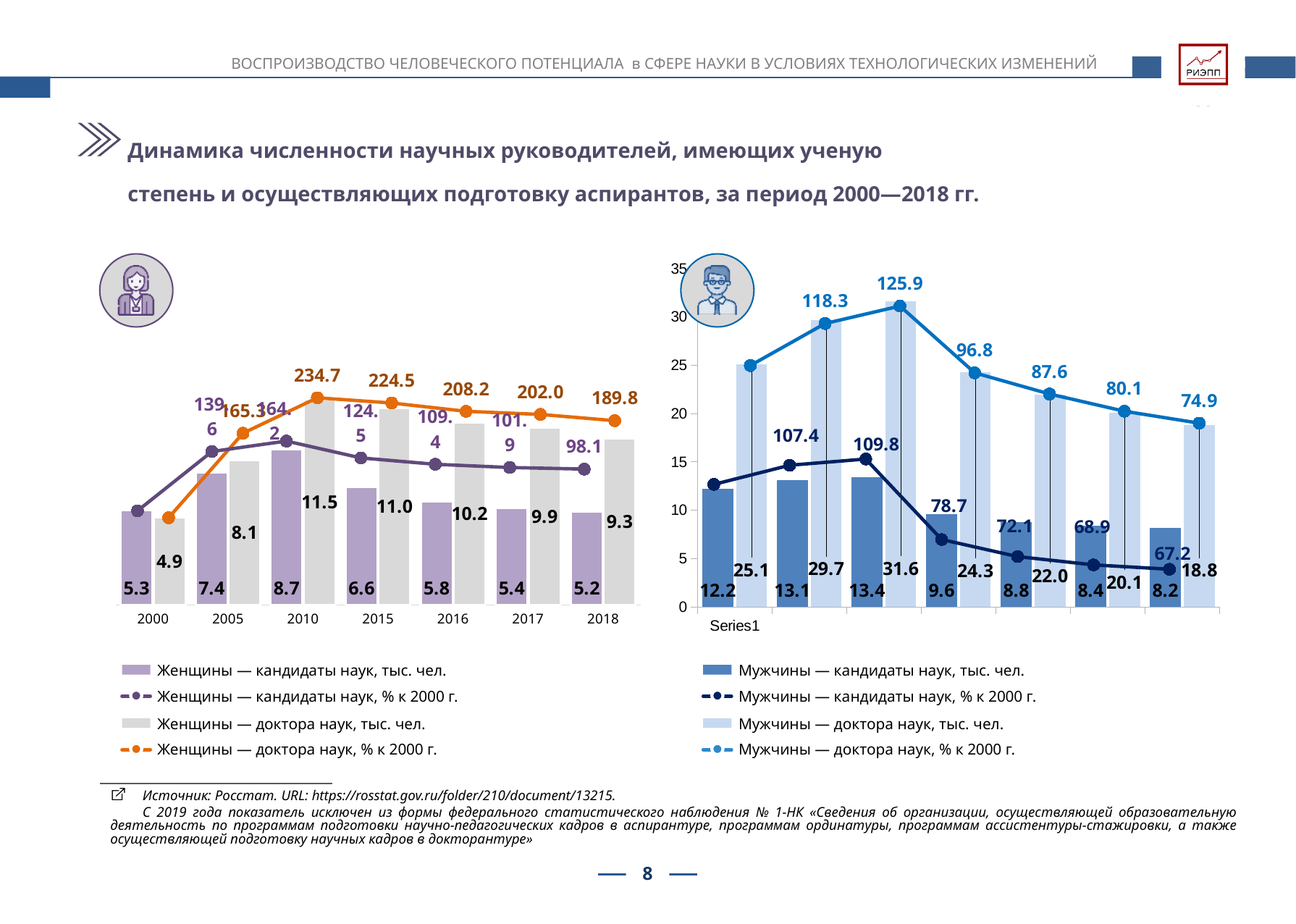
In the left chart (women), what is the value for 'Женщины — доктора наук, тыс. чел.' in 2018? 9.3 In the left chart (women), which year has the lowest value for 'Женщины — кандидаты наук, тыс. чел.'? 2018 In the left chart (women), what is the value for 'Женщины — доктора наук, % к 2000 г.' in 2010? 234.7 In the left chart (women), what is the value for 'Женщины — кандидаты наук, тыс. чел.' in 2010? 8.7 In the left chart (women), how many years are shown on the x axis? 7 In the left chart (women), what is the difference between 'Женщины — доктора наук, тыс. чел.' in 2010 and in 2000? 6.6 In the right chart (men), what is the lowest value for 'Мужчины — кандидаты наук, тыс. чел.'? 8.2 In the left chart (women), which year has the highest value for 'Женщины — доктора наук, тыс. чел.'? 2010 In the right chart (men), what is the peak value of the line 'Мужчины — доктора наук, % к 2000 г.'? 125.9 In the left chart (women), how many series does the legend list? 4 In the left chart (women), in 2015, which is larger: 'Женщины — кандидаты наук, тыс. чел.' or 'Женщины — доктора наук, тыс. чел.'? Женщины — доктора наук, тыс. чел. In the right chart (men), what is the highest value for 'Мужчины — доктора наук, тыс. чел.'? 31.6